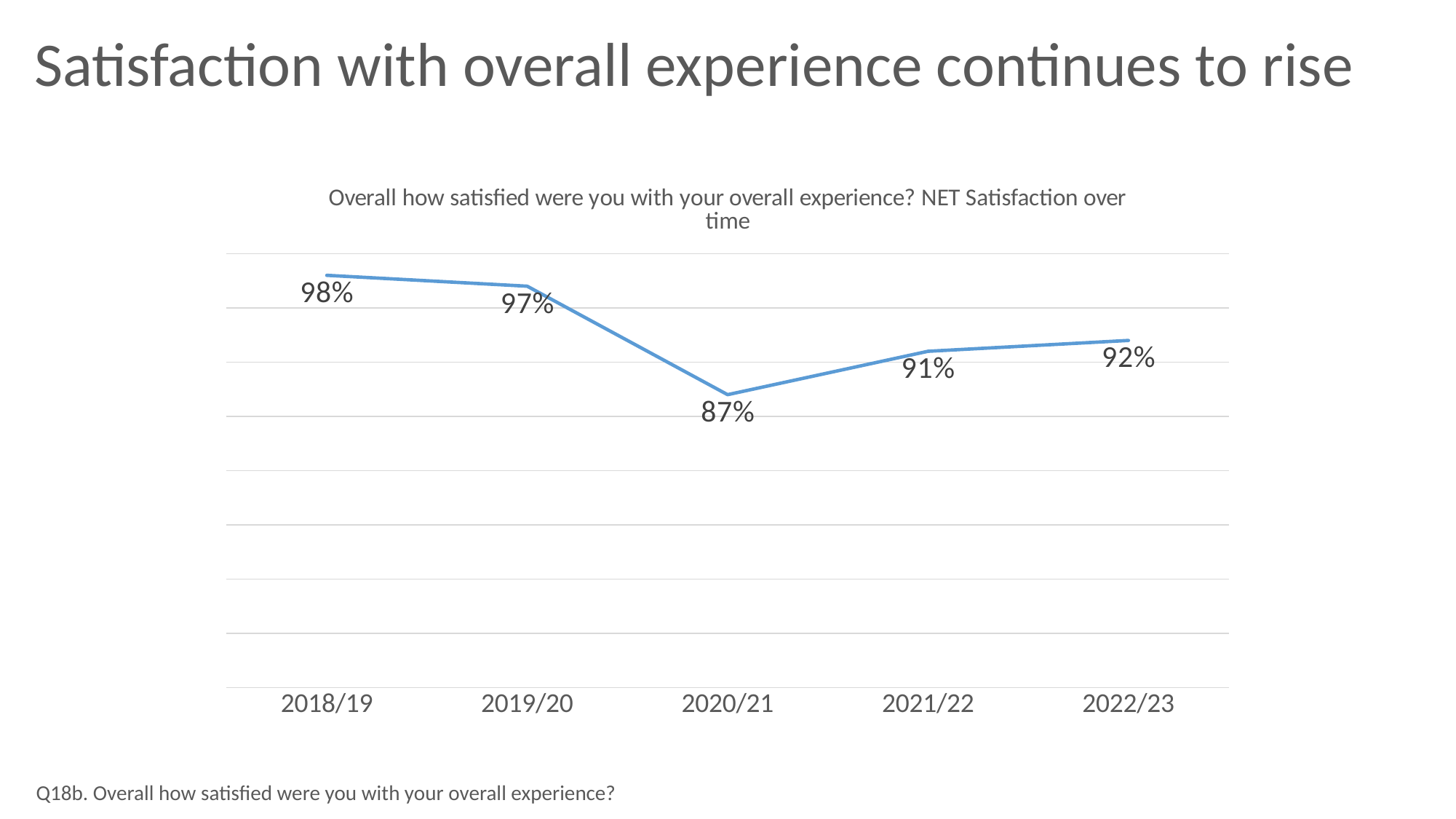
How many years are plotted on the chart? 5 What kind of chart is shown on the slide? Line chart Which year has the lowest NET satisfaction? 2020/21 Does NET satisfaction rise or fall from 2020/21 to 2022/23? Rise Which year has the highest NET satisfaction? 2018/19 Which is larger, the NET satisfaction in 2019/20 or in 2022/23? 2019/20 What is the NET satisfaction value for 2018/19? 98% What is the NET satisfaction value for 2021/22? 91% What is the NET satisfaction value for 2020/21? 87% What is the title of the chart? Overall how satisfied were you with your overall experience? NET Satisfaction over time What is the difference between the NET satisfaction in 2018/19 and 2020/21? 11% What is the NET satisfaction value for 2022/23? 92%